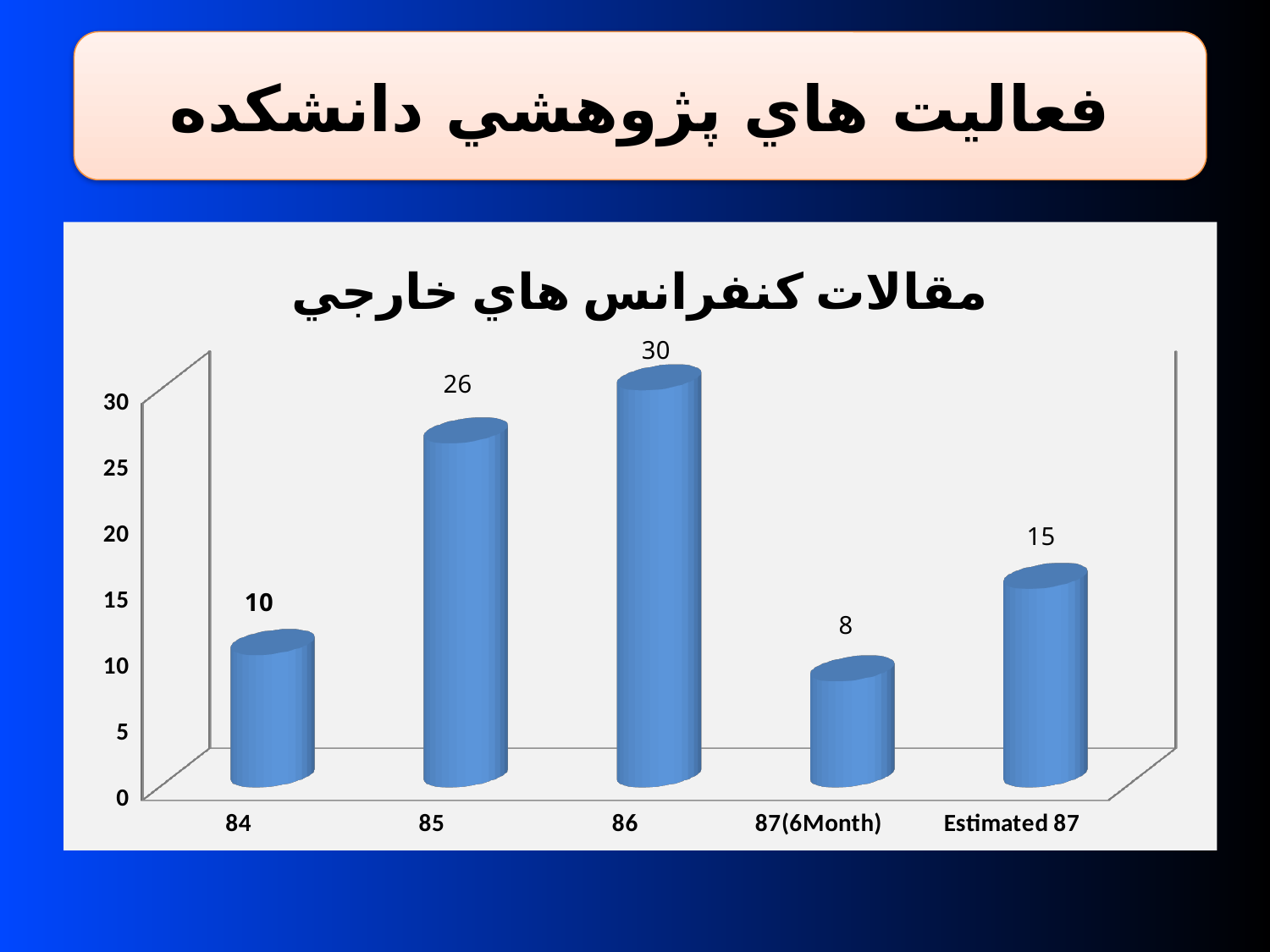
How many categories are shown on the x axis? 5 What is the value for 84? 10 What is the difference between the values for 86 and 85? 4 Is the value for 85 greater or less than 20? greater What is the value for 87(6Month)? 8 Which category has the highest value? 86 Which category has the lowest value? 87(6Month) What is the value for Estimated 87? 15 What is the value for 85? 26 Which is larger, the value for 84 or the value for Estimated 87? Estimated 87 What kind of chart is shown on the slide? bar chart What is the title of the chart? مقالات كنفرانس هاي خارجي